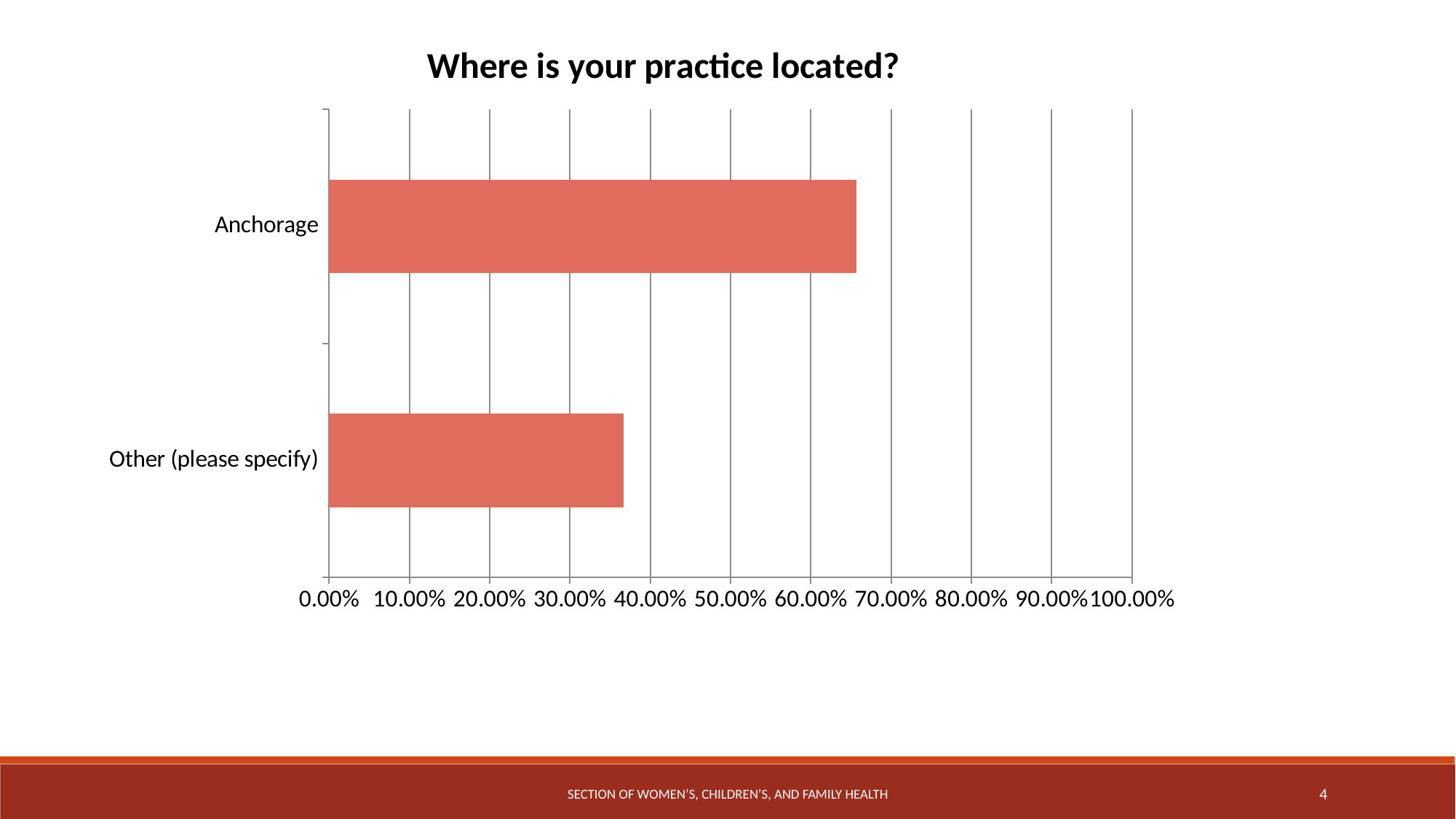
What kind of chart is shown on the slide? bar chart What is the maximum value shown on the horizontal axis? 100.00% How many categories are plotted in the chart? 2 Is the value for Anchorage greater or less than 70.00%? less Is the value for Other (please specify) greater or less than 40.00%? less Which category has the highest value? Anchorage Is the value for Anchorage greater or less than 60.00%? greater Which category has the lowest value? Other (please specify) Which is larger, the value for Anchorage or the value for Other (please specify)? Anchorage What is the title of the chart? Where is your practice located?